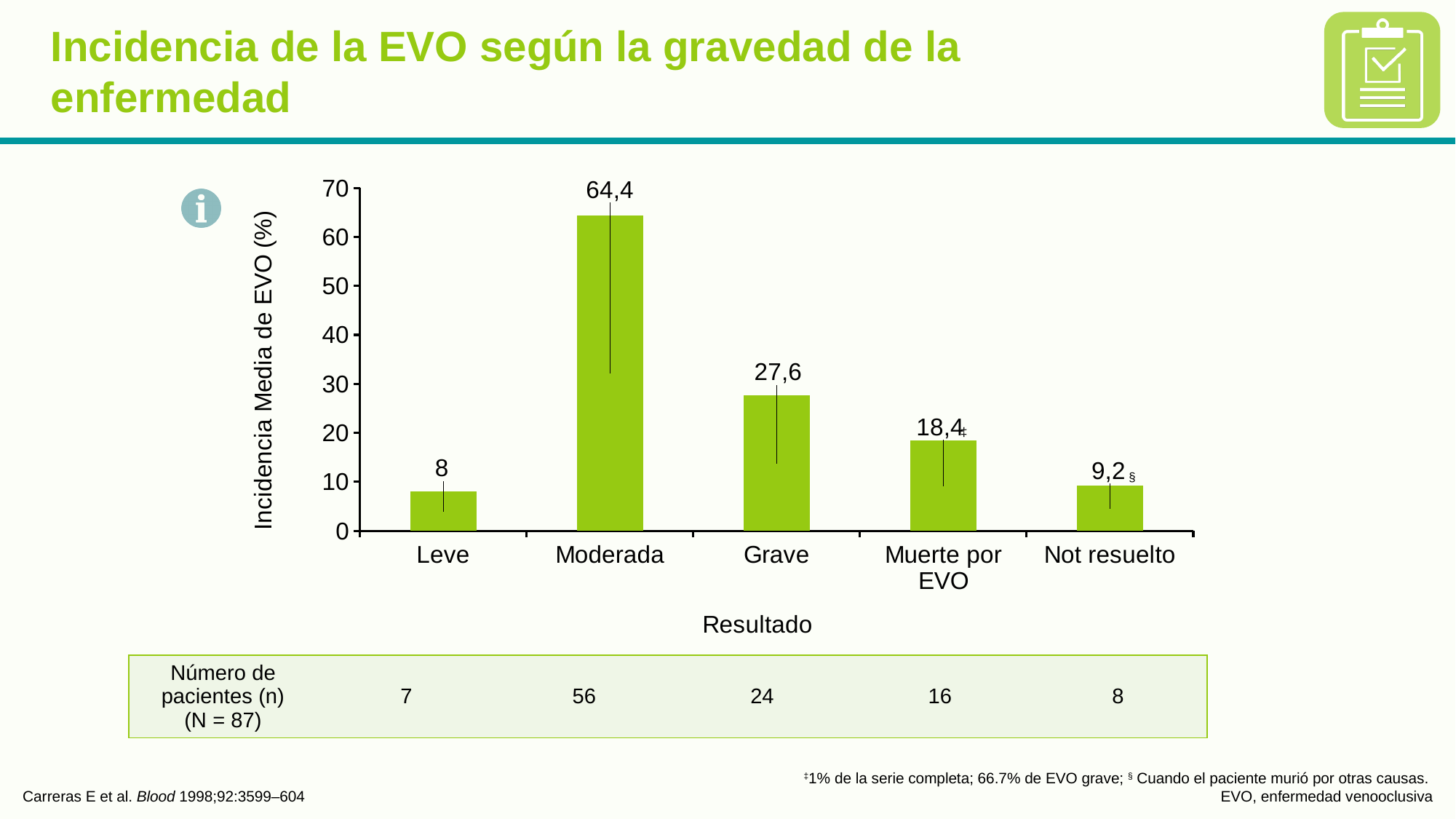
Which has a higher mean incidence of EVO, Grave or Muerte por EVO? Grave Is the value for Moderada greater or less than 60? greater What is the label of the y axis of the chart? Incidencia Media de EVO (%) What is the mean incidence of EVO (%) for Not resuelto? 9,2 How many categories are shown on the x axis of the chart? 5 What is the mean incidence of EVO (%) for the Grave category? 27,6 What is the mean incidence of EVO (%) for Muerte por EVO? 18,4 What kind of chart is shown on the slide? Bar chart Which category has the lowest mean incidence of EVO? Leve Which category has the highest mean incidence of EVO? Moderada What is the difference in mean incidence of EVO between Moderada and Grave? 36,8 What is the mean incidence of EVO (%) for the Moderada category? 64,4